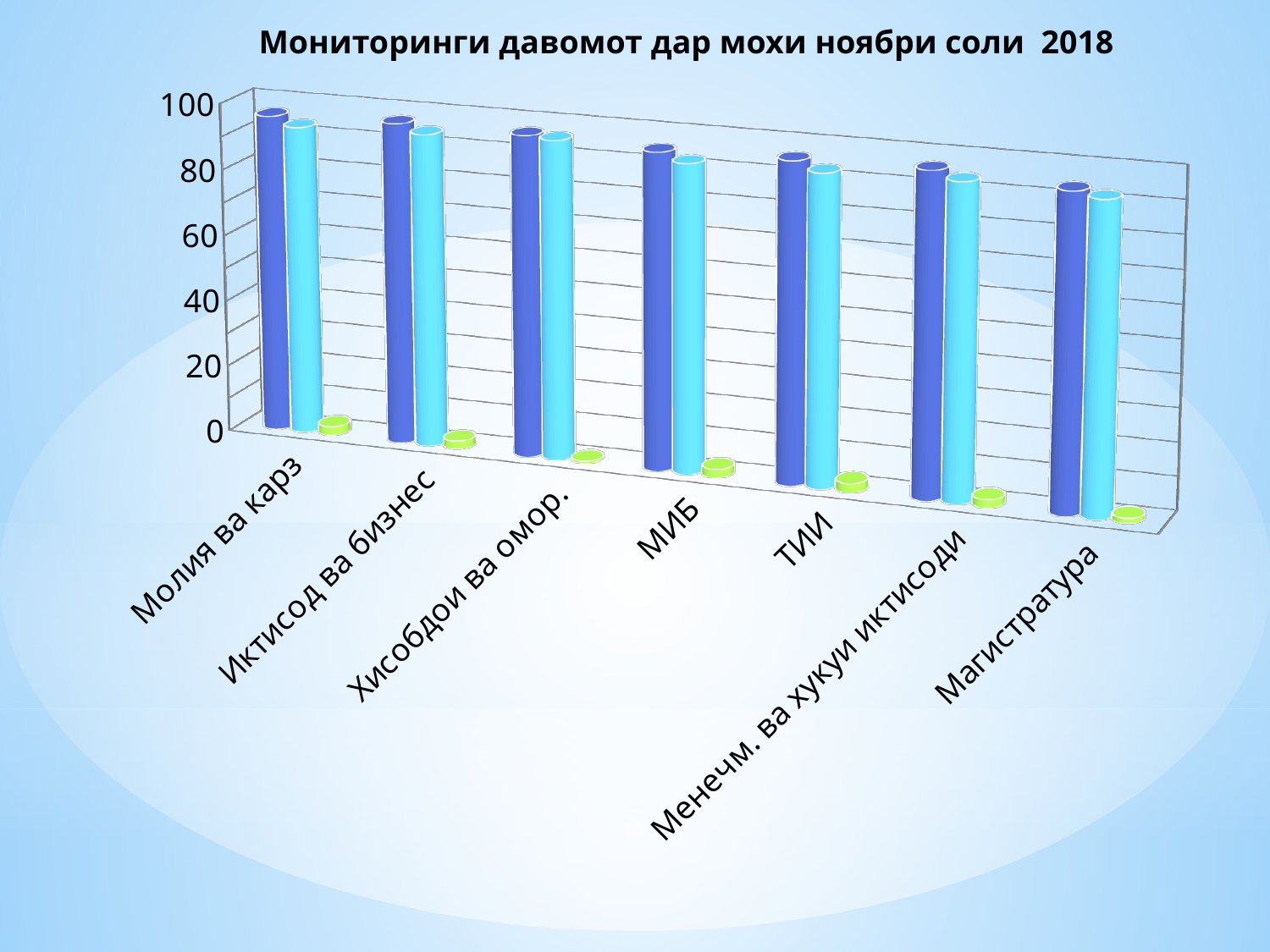
Is the dark blue bar for Молия ва карз greater or less than 80? greater How many categories are shown on the x axis of the chart? 7 Which is larger, the dark blue bar for Молия ва карз or the dark blue bar for Магистратура? Молия ва карз Is the green bar for МИБ greater or less than 20? less What is the title of the chart? Мониторинги давомот дар мохи ноябри соли 2018 Is the dark blue bar for Магистратура greater or less than 60? greater How many bars are plotted for each category in the chart? 3 What kind of chart is shown on the slide? bar chart Which category has the shortest light blue bar? Магистратура Which category has the shortest dark blue bar? Магистратура